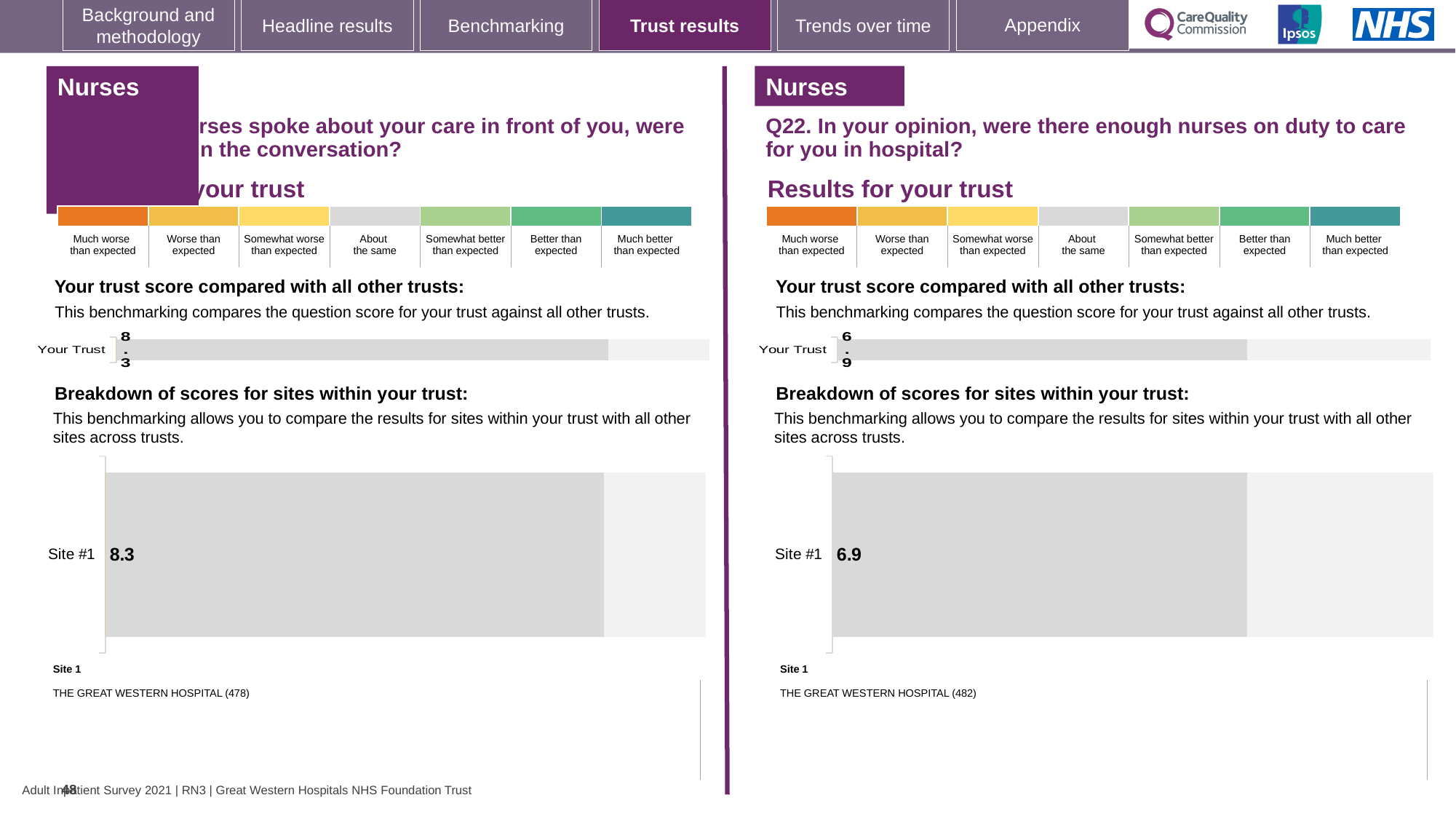
How many sites are plotted in the right-hand 'Breakdown of scores for sites within your trust' chart (Q22)? 1 In the left-hand 'Breakdown of scores for sites within your trust' chart, what is the value for Site #1? 8.3 In the right-hand 'Breakdown of scores for sites within your trust' chart (Q22), what is the value for Site #1? 6.9 Is the Your Trust score in the right-hand section (Q22) greater or less than the Your Trust score in the left-hand section? less Which is larger: the Site #1 score in the left-hand breakdown chart or the Site #1 score in the right-hand breakdown chart (Q22)? The left-hand chart (8.3) Which site is listed as Site 1 beneath the left-hand breakdown chart? THE GREAT WESTERN HOSPITAL (478) On the right-hand slide section (Q22), what is the score shown for Your Trust? 6.9 On the left-hand slide section, what is the score shown for Your Trust? 8.3 What is the difference between the Site #1 score in the left-hand breakdown chart (8.3) and the Site #1 score in the right-hand breakdown chart (6.9)? 1.4 What type of chart is used for the 'Breakdown of scores for sites within your trust' on the right-hand section (Q22)? Bar chart How many sites are plotted in the left-hand 'Breakdown of scores for sites within your trust' chart? 1 Which site is listed as Site 1 beneath the right-hand breakdown chart (Q22)? THE GREAT WESTERN HOSPITAL (482)